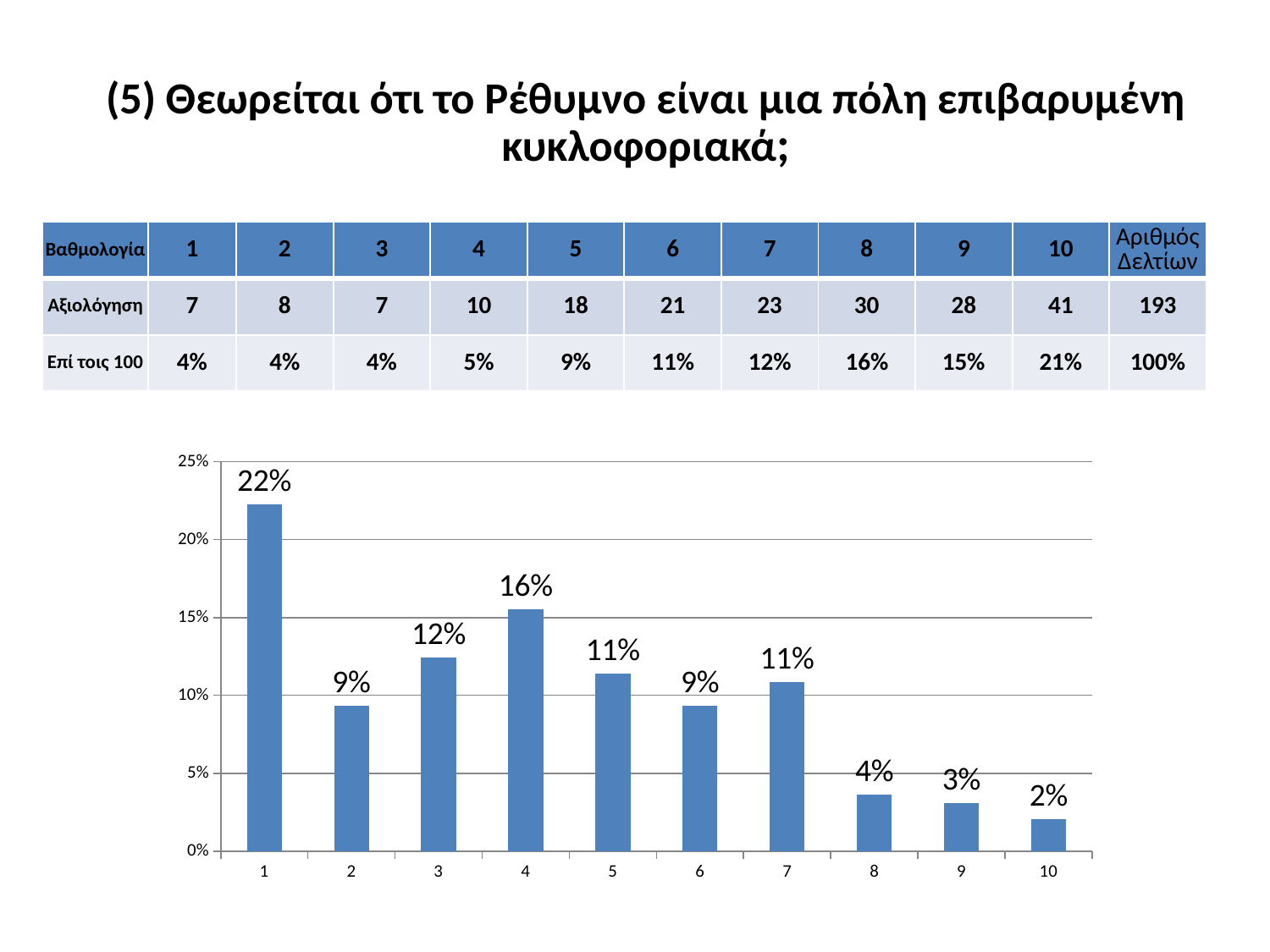
Which category has the lowest value in the chart? 10 What is the difference between the values for category 1 and category 4 in the chart? 6% Which has the larger value in the chart, category 3 or category 7? category 3 What kind of chart is shown on the slide? bar chart What is the value shown for category 4 in the chart? 16% What is the value shown for category 10 in the chart? 2% What is the difference between the values for category 3 and category 8 in the chart? 8% What is the value shown for category 9 in the chart? 3% Is the value for category 1 in the chart greater or less than 20%? greater Which category has the highest value in the chart? 1 What is the value shown for category 1 in the chart? 22% How many categories are plotted on the x axis of the chart? 10